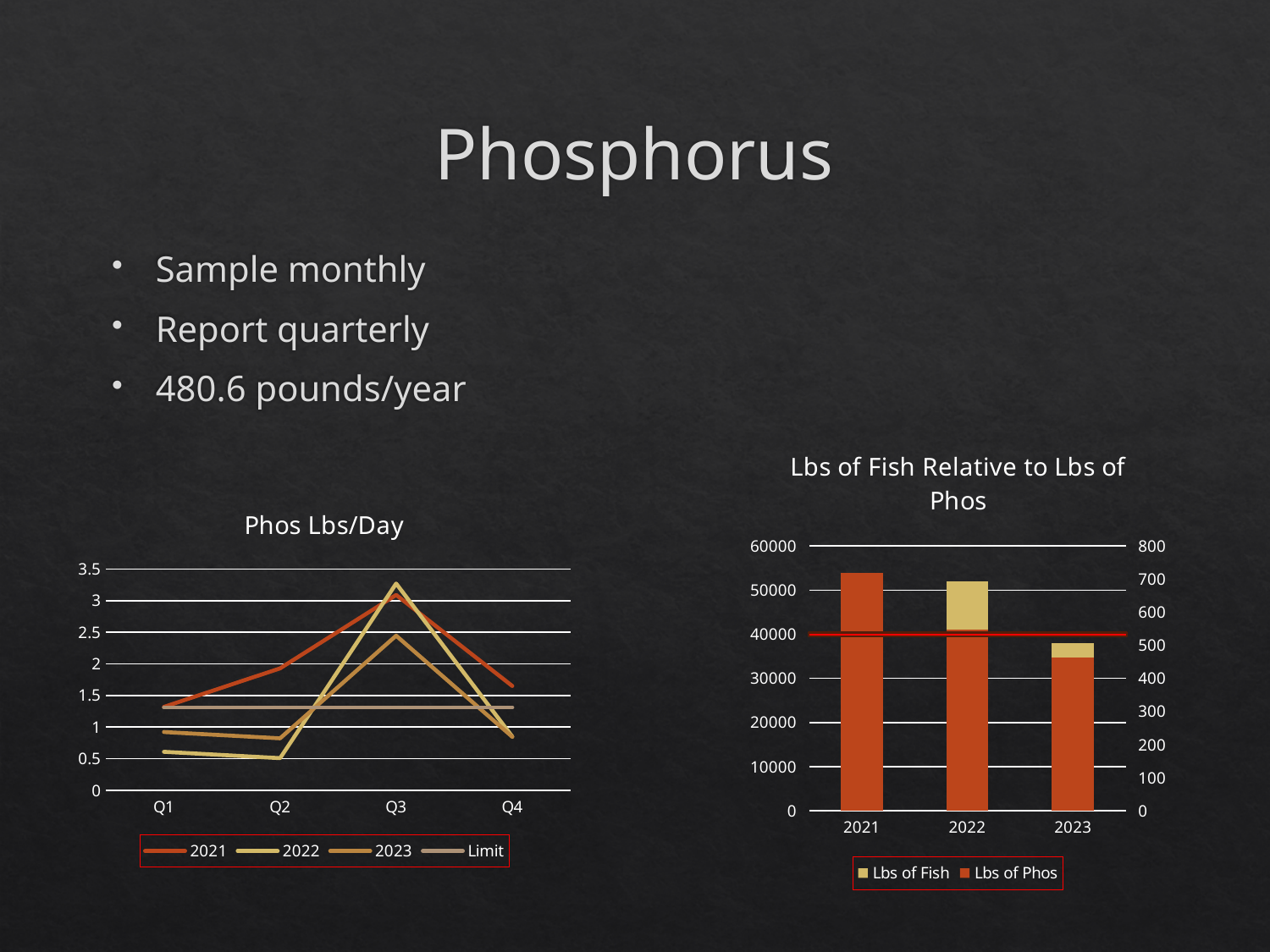
In the "Phos Lbs/Day" chart, is the 2021 value at Q2 greater or less than 1.5? greater In the "Lbs of Fish Relative to Lbs of Phos" chart, which year has the tallest Lbs of Phos bar? 2021 In the "Phos Lbs/Day" chart, is the 2023 value at Q1 greater or less than 1? less In the "Lbs of Fish Relative to Lbs of Phos" chart, do the Lbs of Phos bars rise or fall from 2021 to 2023? fall In the "Phos Lbs/Day" chart, in which quarter does the 2023 series reach its highest value? Q3 What kind of chart is the "Phos Lbs/Day" chart? line chart How many quarters are shown on the x axis of the "Phos Lbs/Day" chart? 4 How many series does the legend of the "Phos Lbs/Day" chart list? 4 How many series does the legend of the "Lbs of Fish Relative to Lbs of Phos" chart list? 2 How many years are shown on the x axis of the "Lbs of Fish Relative to Lbs of Phos" chart? 3 What kind of chart is the "Lbs of Fish Relative to Lbs of Phos" chart? bar chart In the "Phos Lbs/Day" chart, which series has the lowest value at Q1? 2022